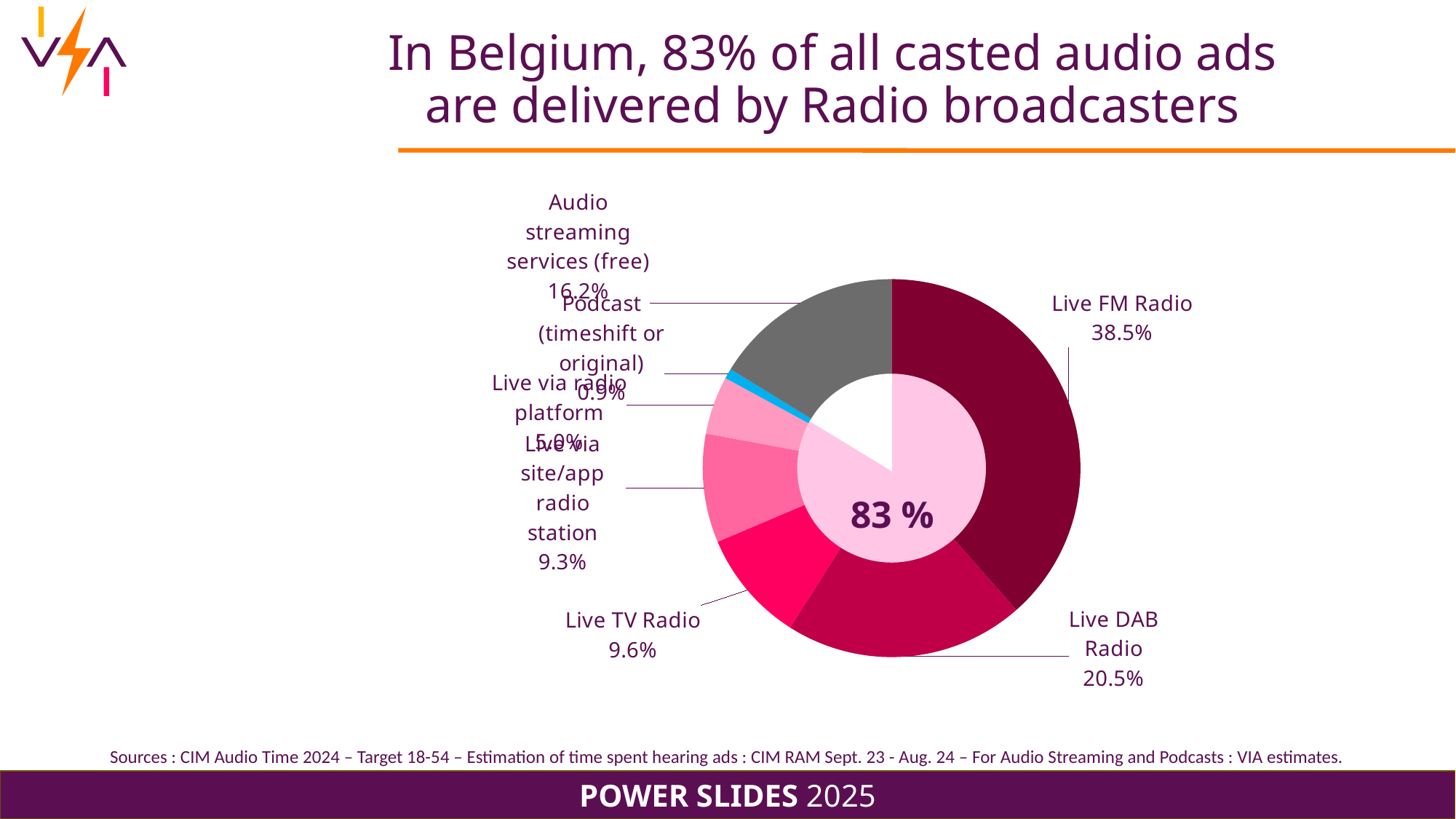
Which category has the largest slice of the chart? Live FM Radio What is the value shown for Live TV Radio? 9.6% What is the value shown for Live DAB Radio? 20.5% What is the difference between the Live DAB Radio and Audio streaming services (free) values? 4.3% What is the difference between the Live FM Radio and Live DAB Radio values? 18.0% How many categories are shown in the chart? 7 What share of casted audio ads is delivered by Live FM Radio? 38.5% What is the value shown for Audio streaming services (free)? 16.2% What is the value shown for Live via site/app radio station? 9.3% What kind of chart is shown on the slide? pie chart (donut) Which category has the smallest slice of the chart? Podcast (timeshift or original) Which is larger, Live TV Radio or Live via site/app radio station? Live TV Radio